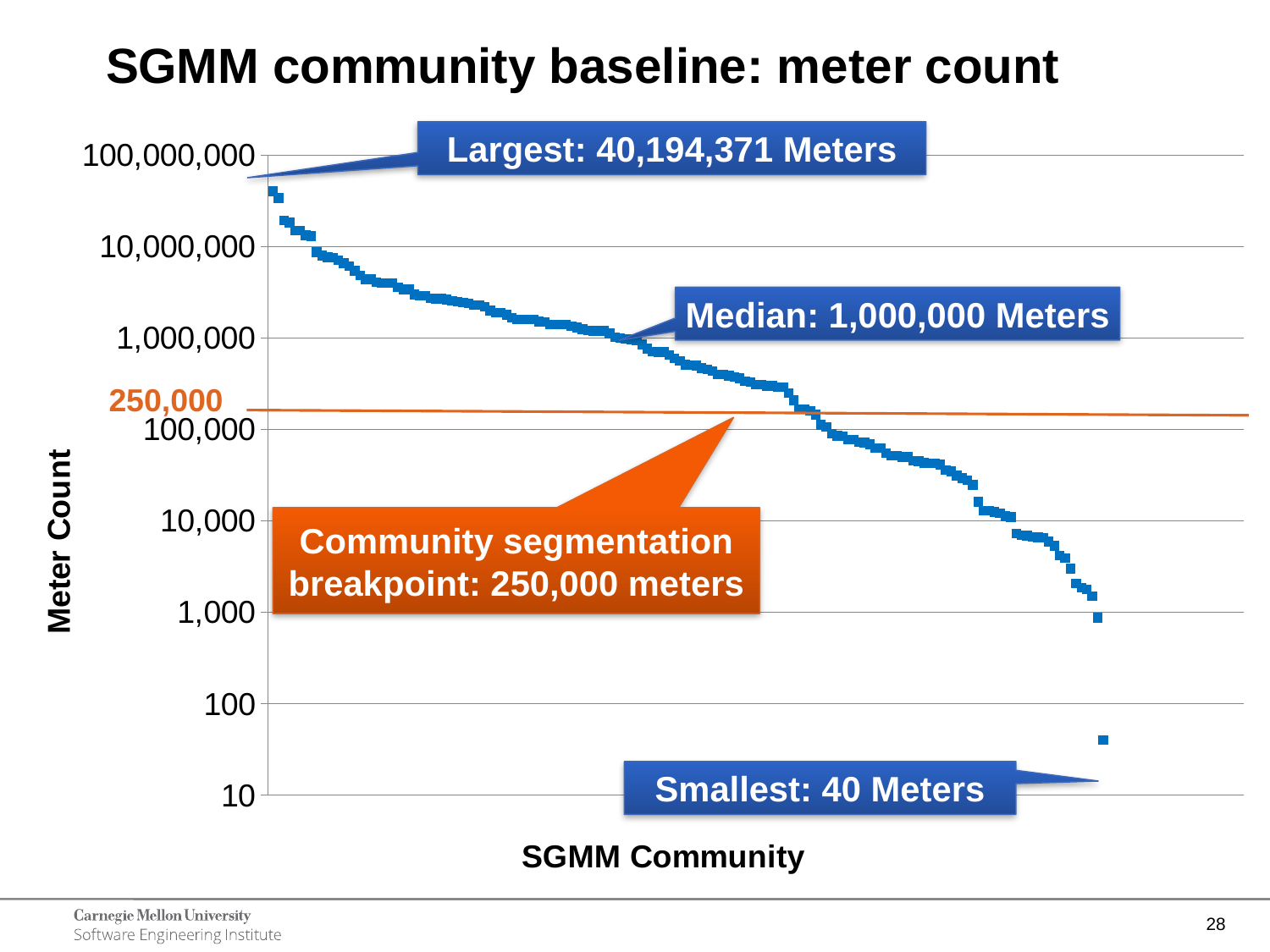
What is the difference between the largest and smallest meter counts shown? 40,194,331 What is the label of the y axis? Meter Count What kind of chart is shown on the slide? Scatter chart What is the largest meter count shown on the chart? 40,194,371 Meters What is the smallest meter count shown on the chart? 40 Meters Which is larger, the median meter count or the community segmentation breakpoint? The median meter count What is the difference between the median meter count and the community segmentation breakpoint? 750,000 At what meter count is the community segmentation breakpoint drawn? 250,000 meters Do the meter counts rise or fall from left to right along the x axis? fall Is the largest meter count greater or less than 10,000,000? greater Is the smallest meter count greater or less than 100? less What is the median meter count labelled on the chart? 1,000,000 Meters